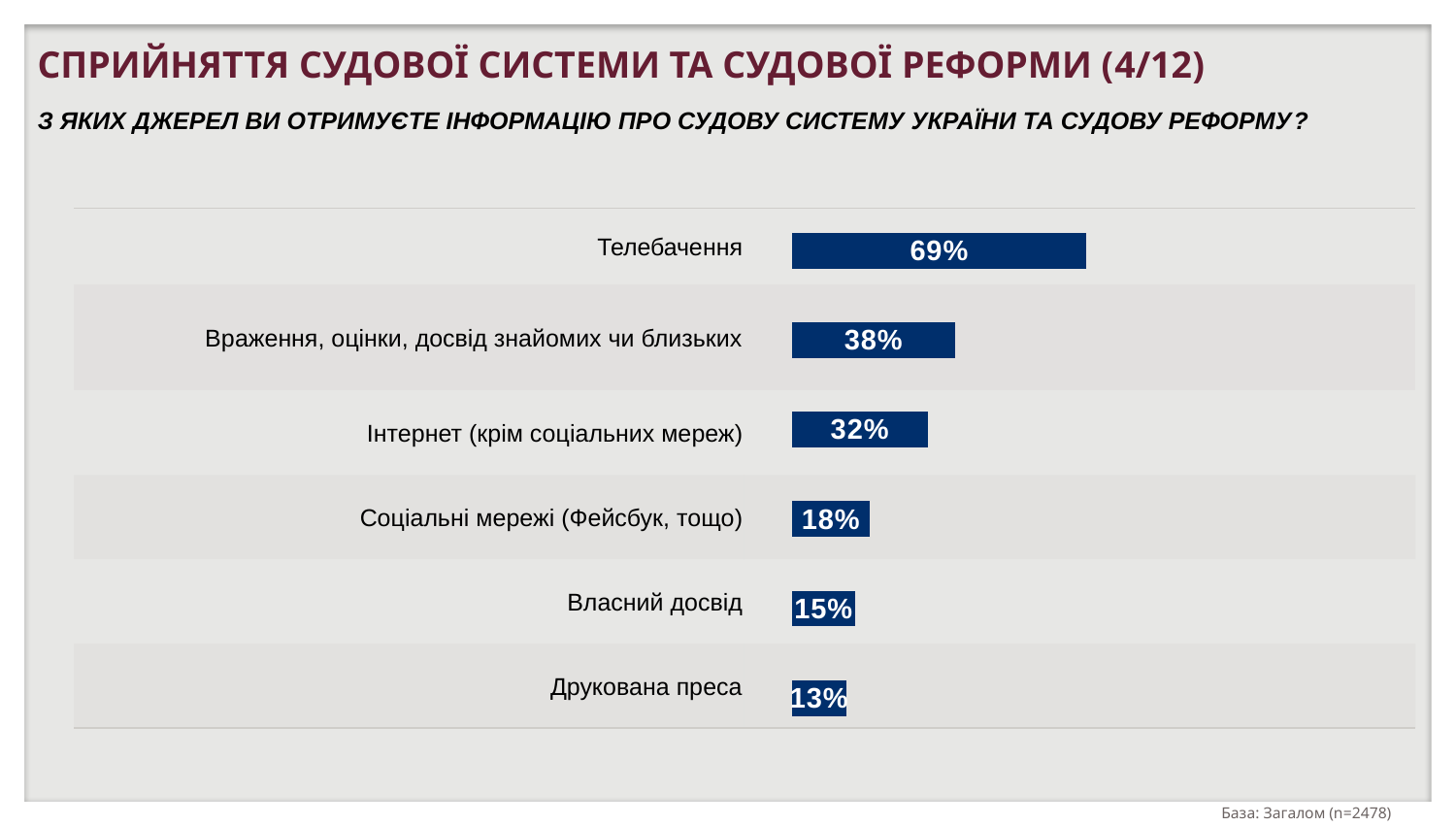
What is the value for Інтернет (крім соціальних мереж)? 32% What is the difference between the values for Телебачення and Враження, оцінки, досвід знайомих чи близьких? 31% What is the value for Друкована преса? 13% Which category has the lowest value? Друкована преса What is the value for Власний досвід? 15% What kind of chart is shown on the slide? Bar chart What is the difference between the values for Соціальні мережі (Фейсбук, тощо) and Власний досвід? 3% How many categories are shown in the chart? 6 What is the value for Телебачення? 69% What is the sample size (base) stated on the slide? n=2478 Which is larger, the value for Інтернет (крім соціальних мереж) or the value for Соціальні мережі (Фейсбук, тощо)? Інтернет (крім соціальних мереж) Which category has the highest value? Телебачення